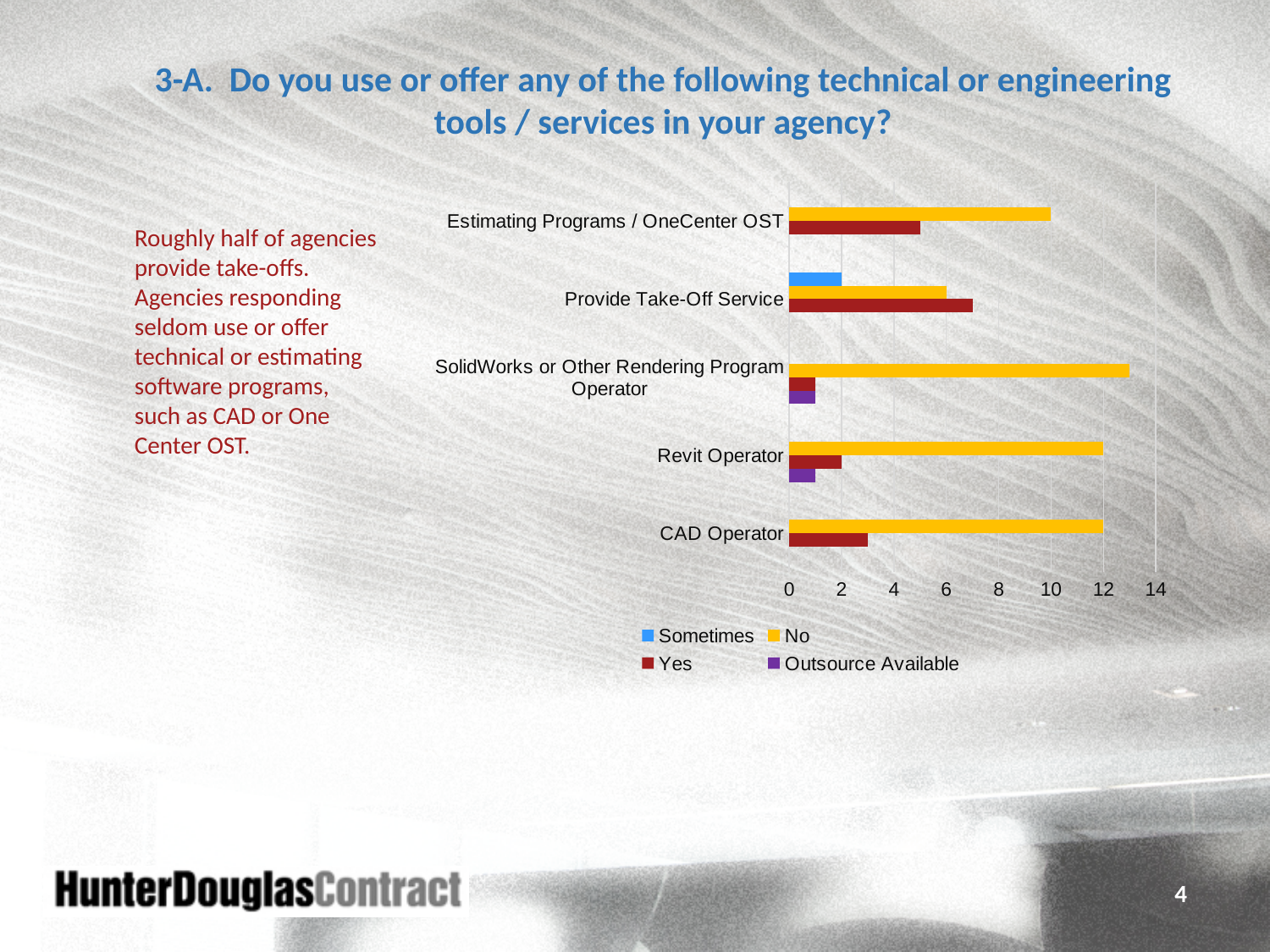
Is the 'Yes' value for Provide Take-Off Service greater or less than 6? greater How many categories are shown on the chart? 5 Which category has the highest 'No' value? SolidWorks or Other Rendering Program Operator Is the 'Yes' value for CAD Operator greater or less than 4? less How many series does the legend list? 4 What is the 'Sometimes' value for Provide Take-Off Service? 2 What kind of chart is shown on the slide? bar chart Which category has the lowest 'No' value? Provide Take-Off Service Which is larger, the 'Yes' value for Provide Take-Off Service or the 'Yes' value for Estimating Programs / OneCenter OST? Provide Take-Off Service What is the 'No' value for Estimating Programs / OneCenter OST? 10 Which series is shown in yellow in the legend? No What is the 'No' value for CAD Operator? 12